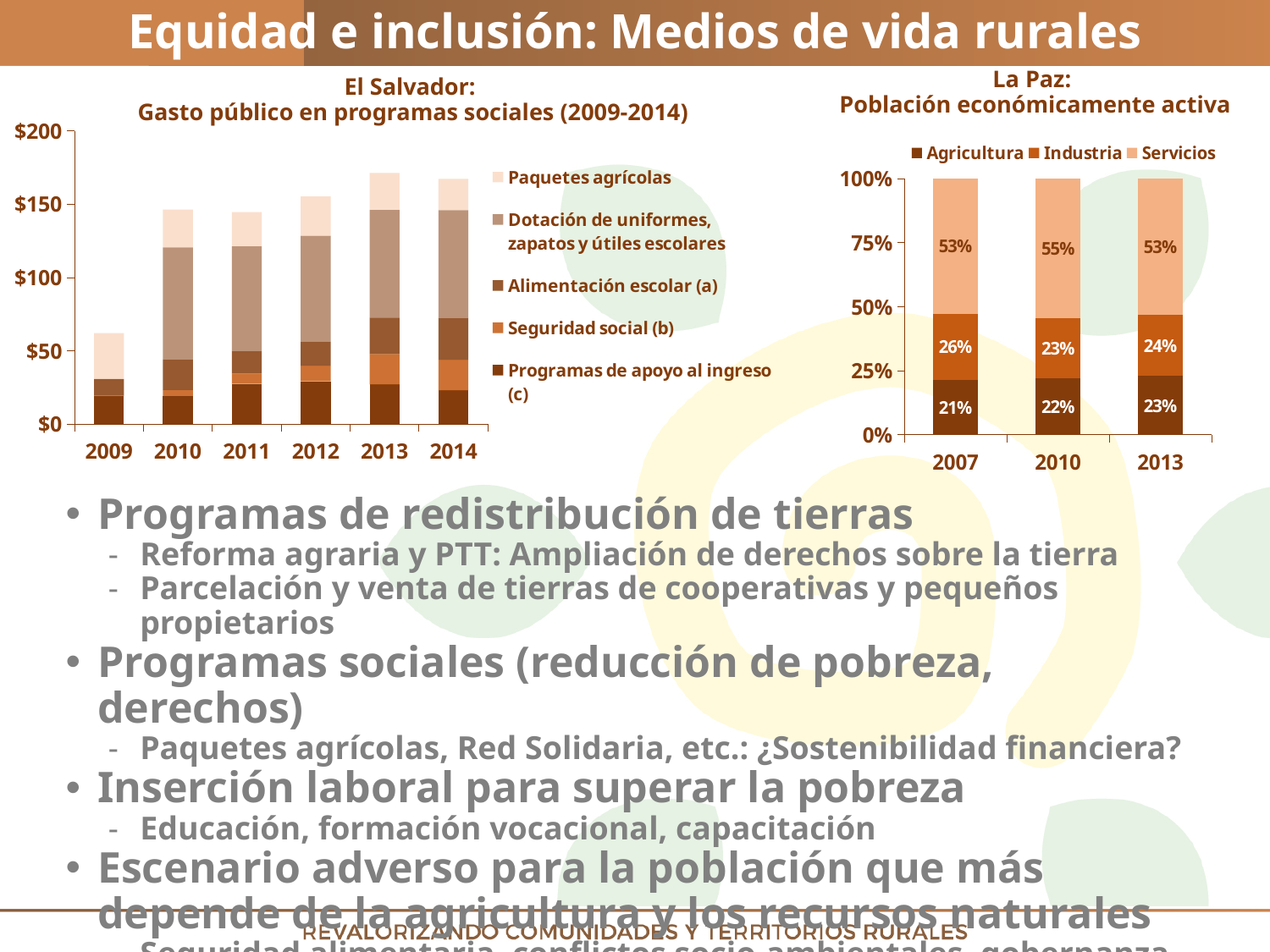
How many series does the legend of the La Paz chart list? 3 In the La Paz chart, what is the Industria value for 2013? 24% In the La Paz chart, which is larger: the Agricultura share in 2013 or in 2007? 2013 How many years are shown on the x axis of the El Salvador chart? 6 How many series does the legend of the El Salvador chart list? 5 In the La Paz chart, in which year was the Agricultura share lowest? 2007 In the La Paz chart, what share of the economically active population was in Servicios in 2010? 55% What kind of chart is the El Salvador chart? stacked bar chart In the La Paz chart, what is the Agricultura value for 2007? 21% In the El Salvador chart, is the total public spending for 2009 greater or less than $100? less In the La Paz chart, in which year was the Industria share highest? 2007 In the La Paz chart, what is the difference between the Industria share in 2007 and in 2013? 2%